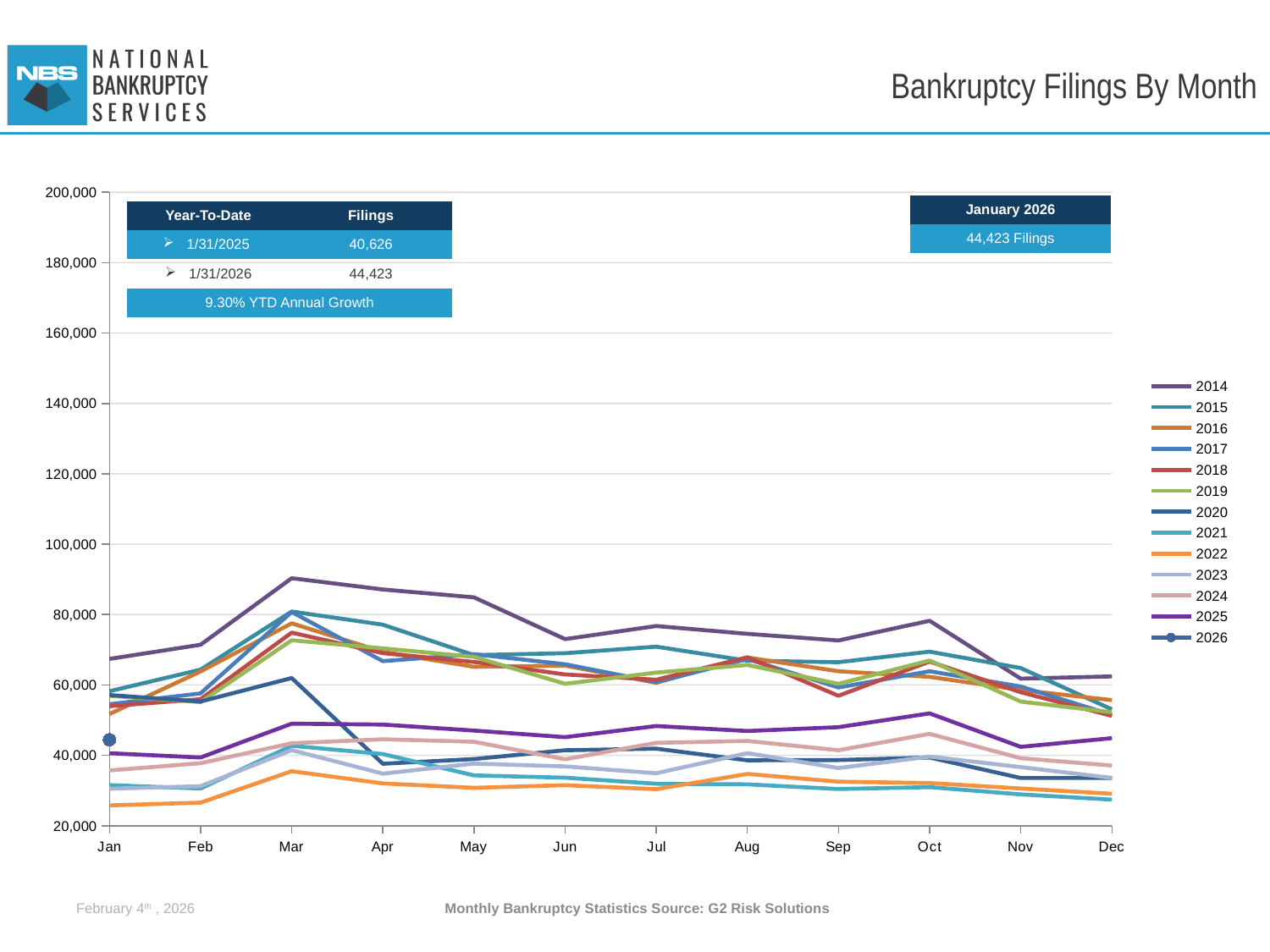
Is the value for 2022 in Jan greater or less than 40,000? less Which is larger in Jul, the value for 2014 or the value for 2022? 2014 What is the difference between the year-to-date filings for 1/31/2026 and 1/31/2025? 3,797 Which year has the highest value in Mar? 2014 Is the value for 2014 in Mar greater or less than 80,000? greater What is the year-to-date filings figure for 1/31/2025? 40,626 What YTD annual growth percentage is shown on the slide? 9.30% How many filings are reported for January 2026? 44,423 How many months are shown along the x axis? 12 How many series does the legend list? 13 Which year has the lowest value in Jan? 2022 What kind of chart is shown on the slide? line chart